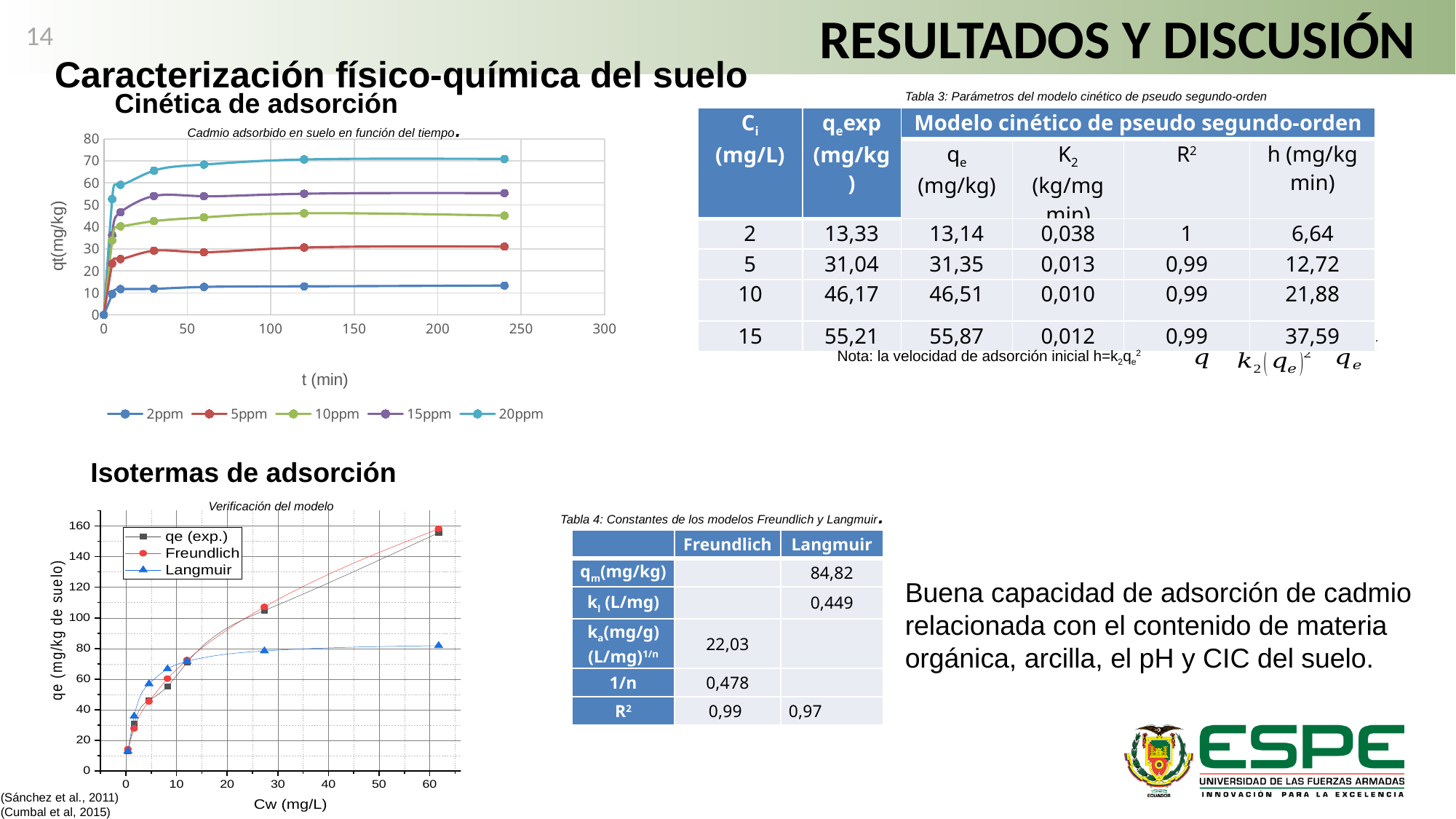
What kind of chart is 'Cadmio adsorbido en suelo en función del tiempo'? line chart In the chart 'Cadmio adsorbido en suelo en función del tiempo', is the value for 2ppm at 240 min greater or less than 20? less In the chart titled 'Verificación del modelo', how many series does the legend list? 3 In the chart 'Cadmio adsorbido en suelo en función del tiempo', which series has the highest qt values? 20ppm In the chart 'Cadmio adsorbido en suelo en función del tiempo', at 120 min, which series has the larger value: 15ppm or 10ppm? 15ppm In the chart titled 'Cadmio adsorbido en suelo en función del tiempo', how many series does the legend list? 5 In the chart 'Verificación del modelo', is the Freundlich value at the highest Cw point greater or less than 140? greater In the chart 'Verificación del modelo', which series has the lowest value at the highest Cw point (around 62 mg/L)? Langmuir What is the x-axis label of the chart 'Cadmio adsorbido en suelo en función del tiempo'? t (min) In the chart 'Cadmio adsorbido en suelo en función del tiempo', which series has the lowest qt values? 2ppm In the chart 'Cadmio adsorbido en suelo en función del tiempo', do the values for 20ppm rise or fall as t increases from 0 to 30 min? rise In the chart 'Cadmio adsorbido en suelo en función del tiempo', is the value for 20ppm at 240 min greater or less than 60? greater